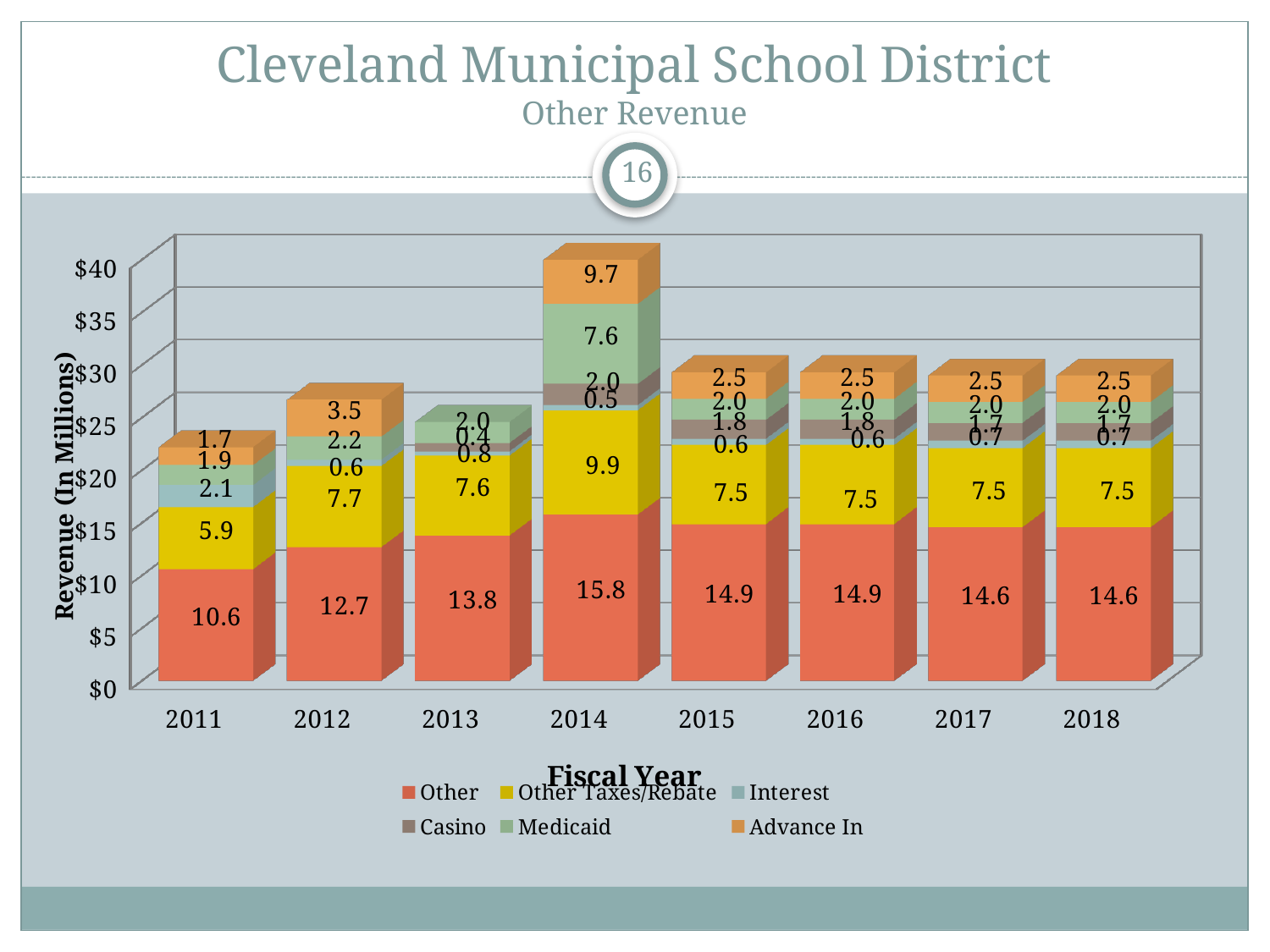
Which is larger, the Other Taxes/Rebate value for 2012 or for 2013? 2012 What is the value of the Other Taxes/Rebate segment for fiscal year 2011? 5.9 What is the value of the Other segment for fiscal year 2014? 15.8 What kind of chart is shown on the slide? Stacked bar chart What is the title of the y axis? Revenue (In Millions) How many fiscal years are shown on the x axis? 8 What is the value of the Advance In segment for fiscal year 2014? 9.7 How many series does the legend list? 6 What is the difference between the Other segment in 2014 and the Other segment in 2011? 5.2 What is the total of the stacked bar for fiscal year 2015? 29.3 Is the total of the 2011 bar greater or less than $25? less Which fiscal year has the highest total other revenue? 2014